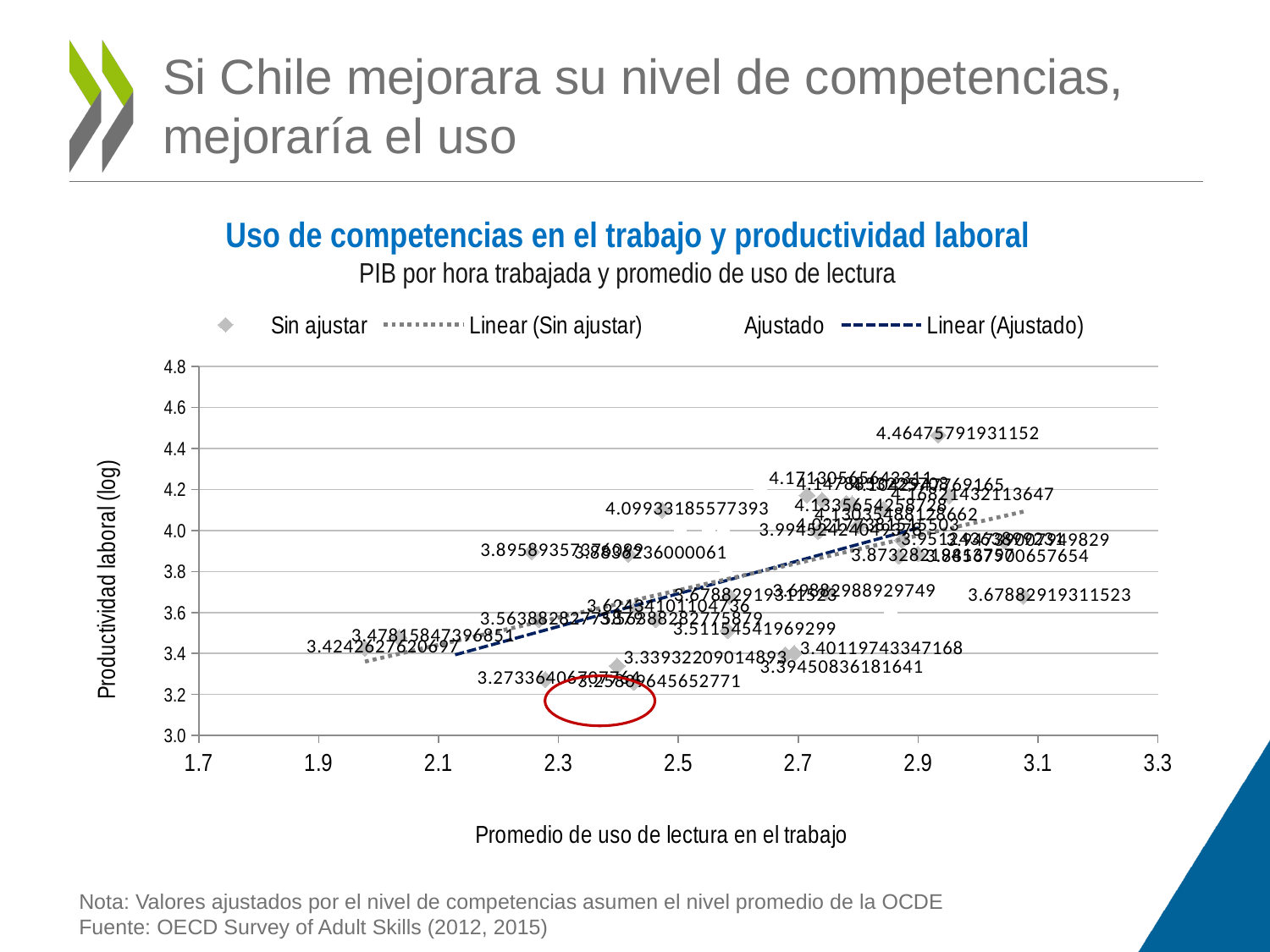
What is the title of the vertical axis? Productividad laboral (log) Is the highest point on the chart greater or less than 4.4? greater Is the point circled in red greater or less than 3.4 on the productivity axis? less How many entries does the chart legend list? 4 What kind of chart is shown on the slide? scatter chart Do the fitted lines on the chart rise or fall as the average reading use at work increases? rise Is the value of the rightmost point (at a reading-use level of about 3.08) greater or less than 3.8? less Which is larger, the point labelled 4.46475791931152 or the point labelled 4.09933185577393? 4.46475791931152 What is the labelled value of the leftmost point on the chart (at a reading-use level of about 1.98)? 3.4242627620697 What is the maximum value shown on the vertical axis? 4.8 What is the title of the horizontal axis? Promedio de uso de lectura en el trabajo What is the highest productivity value labelled on the chart? 4.46475791931152